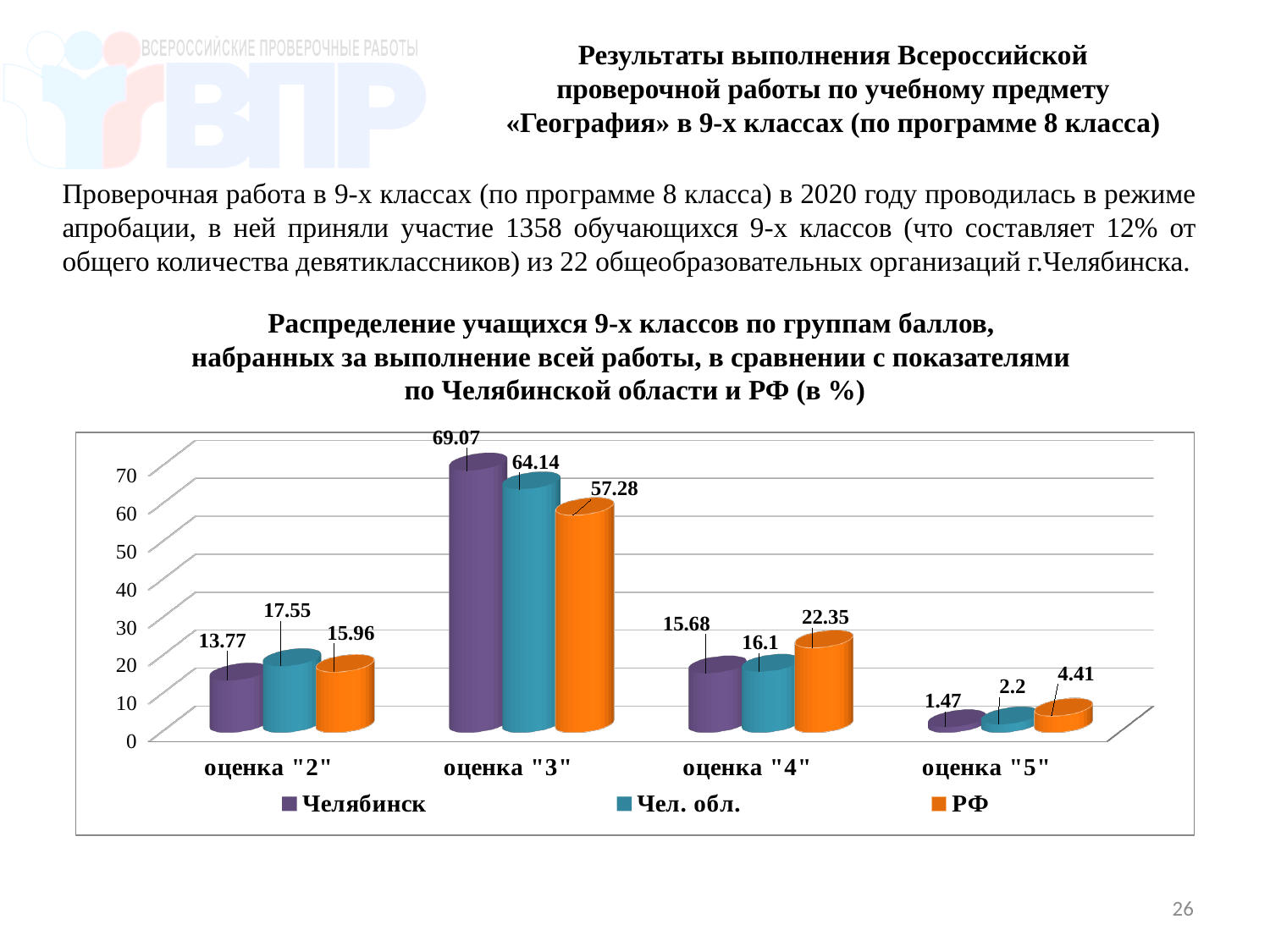
Is the value for Чел. обл. in the category оценка "3" greater or less than 60? greater What is the difference between the Челябинск and РФ values in the category оценка "3"? 11.79 Which category has the highest value for the Челябинск series? оценка "3" Which series is shown in orange in the legend? РФ What kind of chart is shown on the slide? bar chart What is the value for Челябинск in the category оценка "3"? 69.07 Which category has the lowest value for the РФ series? оценка "5" What is the value for РФ in the category оценка "4"? 22.35 How many series does the legend list? 3 How many categories are shown on the x axis? 4 What is the value for Чел. обл. in the category оценка "5"? 2.2 Which is larger in the category оценка "2": the value for Челябинск or for Чел. обл.? Чел. обл.